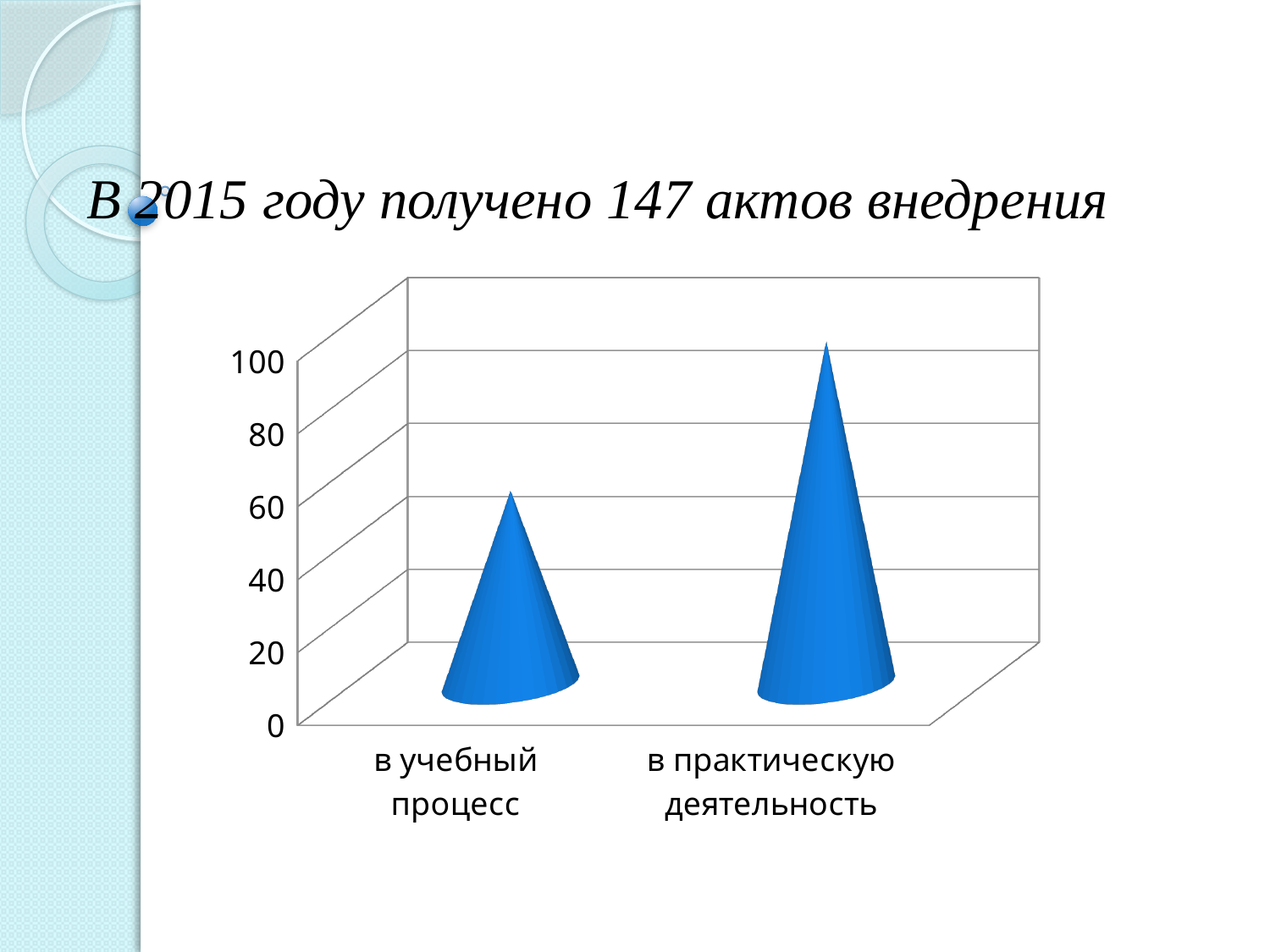
What kind of chart is shown on the slide? bar chart How many categories are shown on the x axis of the chart? 2 Which is larger: the value for "в учебный процесс" or the value for "в практическую деятельность"? в практическую деятельность Is the value for "в практическую деятельность" greater or less than 80? greater Is the value for "в учебный процесс" greater or less than 40? greater Do the values rise or fall from left to right along the x axis? rise What is the highest tick value shown on the vertical axis of the chart? 100 Is the value for "в практическую деятельность" greater or less than 60? greater What is the title of the slide above the chart? В 2015 году получено 147 актов внедрения Which category has the lowest value in the chart? в учебный процесс Which category has the highest value in the chart? в практическую деятельность